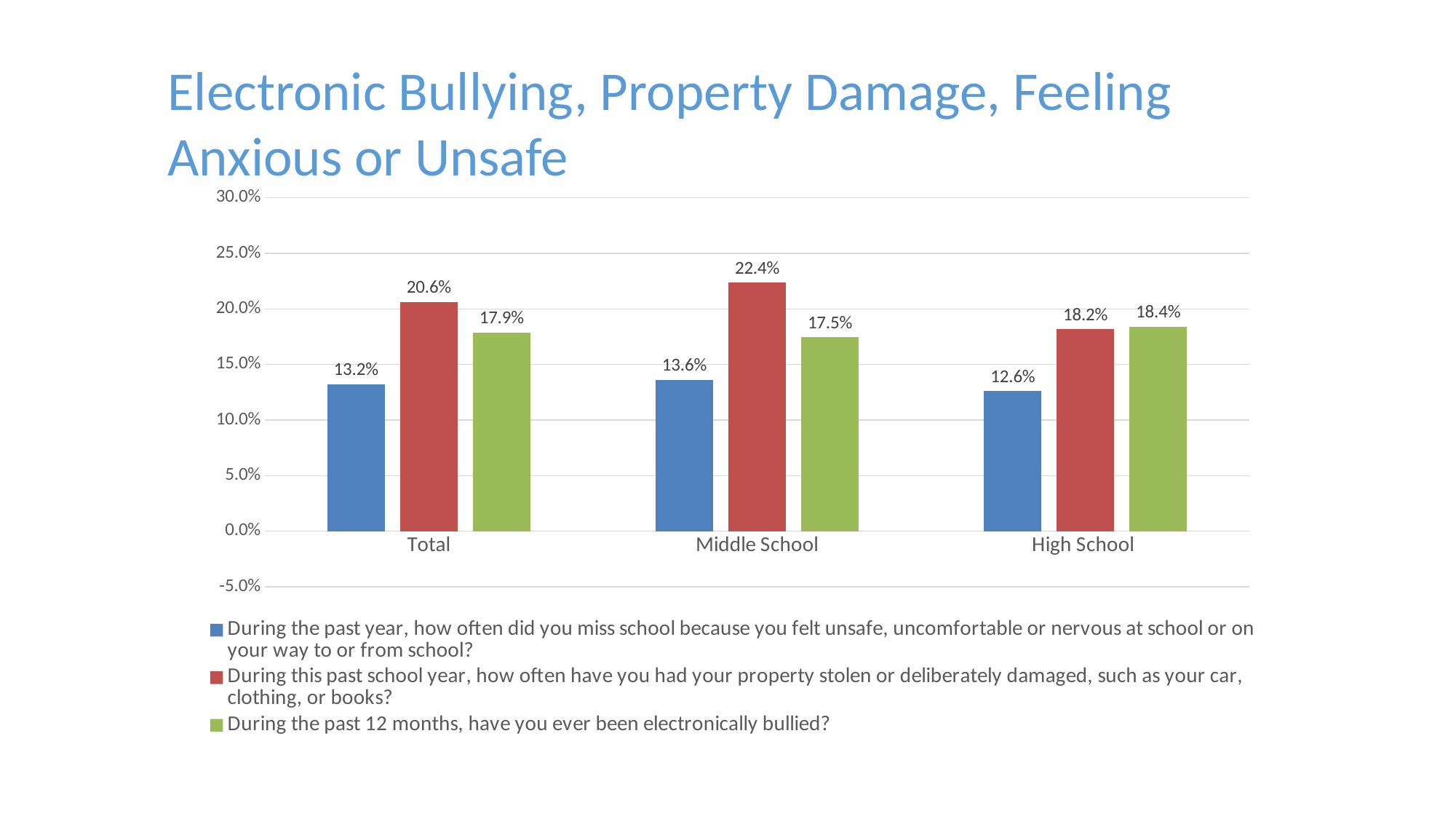
What is the value for Middle School for the series 'During this past school year, how often have you had your property stolen or deliberately damaged, such as your car, clothing, or books?' 22.4% Is the Total value for the electronically bullied series greater or less than 15.0%? greater Which category has the highest value for the property stolen or damaged series? Middle School How many series does the legend list? 3 What colour are the bars for the electronically bullied series? Green What kind of chart is shown on the slide? Bar chart Which category has the lowest value for the missed school because felt unsafe series? High School How many categories are shown on the x axis? 3 What is the Total value for the series 'During the past year, how often did you miss school because you felt unsafe, uncomfortable or nervous at school or on your way to or from school?' 13.2% What is the value for High School for the series 'During the past 12 months, have you ever been electronically bullied?' 18.4% What is the difference between the Middle School and High School values for the property stolen or damaged series? 4.2% For Middle School, which is larger: the property stolen or damaged value or the electronically bullied value? Property stolen or damaged (22.4%)